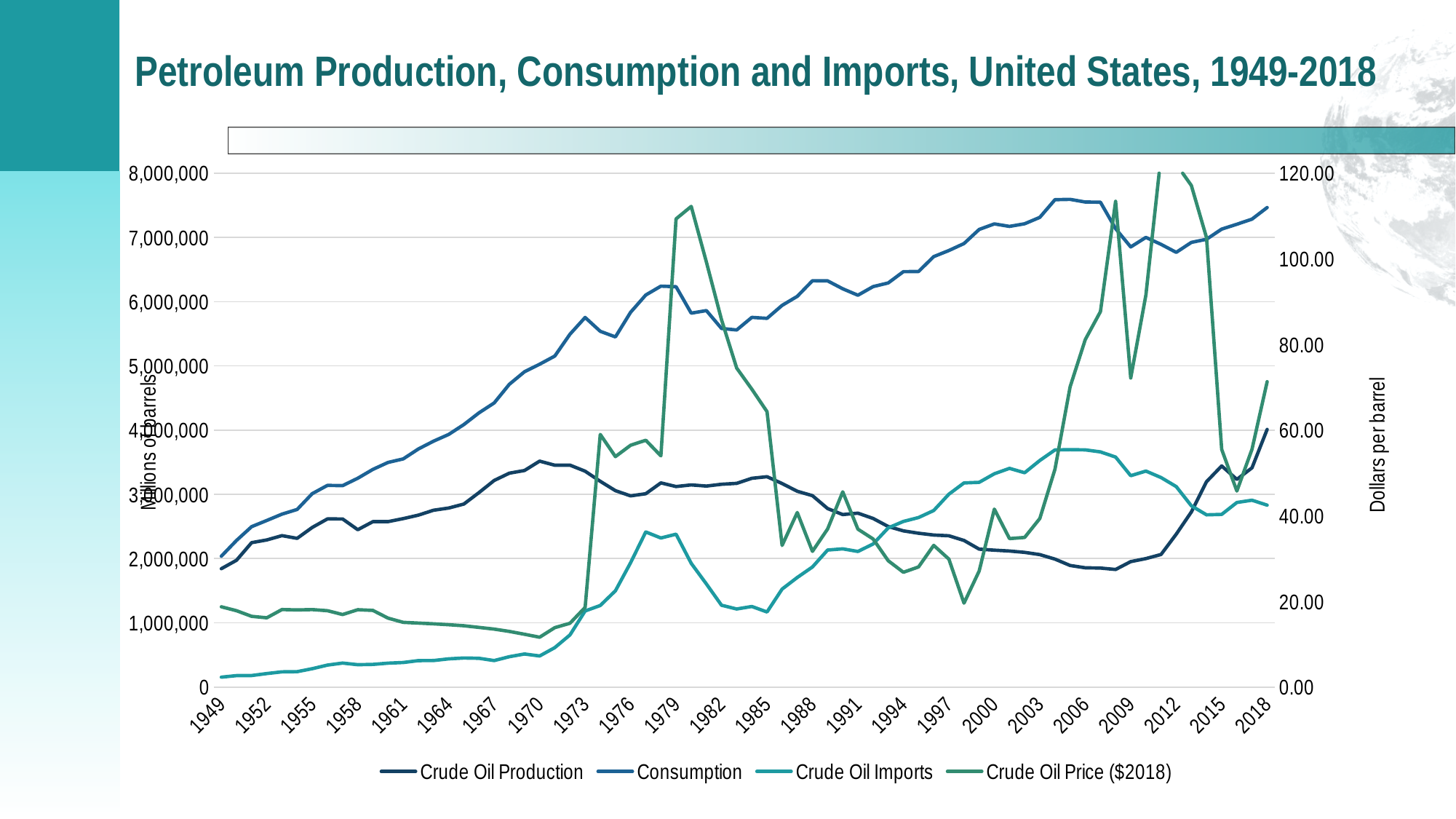
In 2018, which is larger: Consumption or Crude Oil Production? Consumption Is the value for Crude Oil Imports in 1949 greater or less than 1,000,000? less Is the value for Crude Oil Price ($2018) in 1980 greater or less than 100.00? greater Is the value for Consumption in 2018 greater or less than 7,000,000? greater Does Crude Oil Production rise or fall from 1985 to 2008? Fall How many series does the legend list? 4 What is the title of the chart? Petroleum Production, Consumption and Imports, United States, 1949-2018 What kind of chart is shown on the slide? Line chart What is the label of the right-hand vertical axis? Dollars per barrel Does Consumption rise or fall from 1949 to 1973? Rise